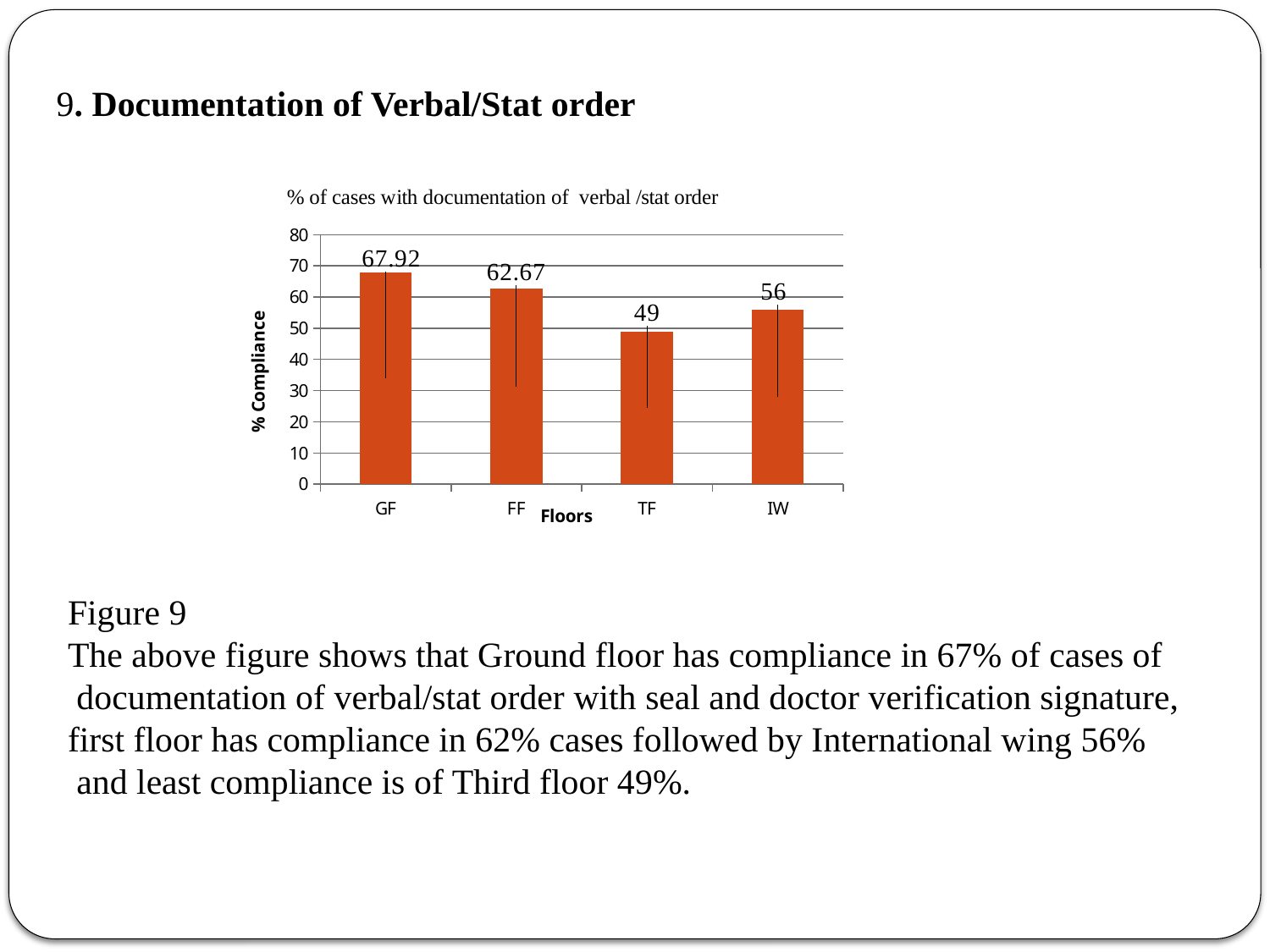
What is the difference between the values for IW and TF? 7 What is the difference between the values for GF and FF? 5.25 Which floor has the lowest % compliance? TF Which floor has the highest % compliance? GF Which is larger, the value for FF or the value for IW? FF What is the title of the chart? % of cases with documentation of verbal /stat order How many floors are shown on the x axis? 4 What is the value for IW? 56 What is the value for FF? 62.67 What kind of chart is shown? bar chart What is the value for GF? 67.92 What is the value for TF? 49